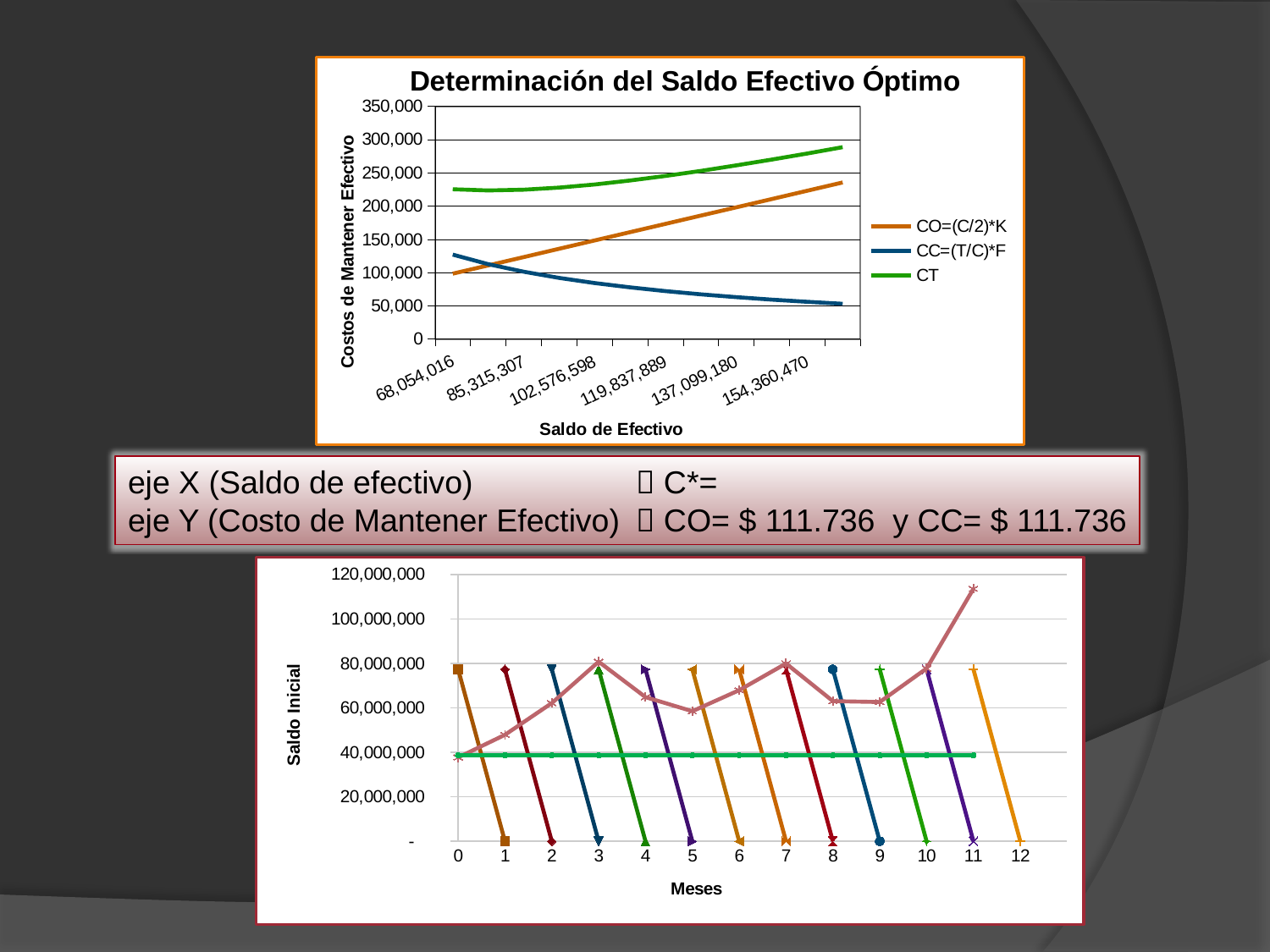
In the bottom chart with 'Meses' on the x axis, is the value of the pink line at month 11 greater or less than 100,000,000? greater What kind of chart is the top chart titled 'Determinación del Saldo Efectivo Óptimo'? line chart In the top chart 'Determinación del Saldo Efectivo Óptimo', is the CC=(T/C)*F value at 154,360,470 greater or less than 100,000? less In the top chart 'Determinación del Saldo Efectivo Óptimo', which series has the highest value at the rightmost point of the x axis? CT What is the y-axis title of the bottom chart with 'Meses' on the x axis? Saldo Inicial In the top chart 'Determinación del Saldo Efectivo Óptimo', does the CC=(T/C)*F series rise or fall as Saldo de Efectivo increases? falls In the top chart 'Determinación del Saldo Efectivo Óptimo', is the CO=(C/2)*K value at 68,054,016 greater or less than 150,000? less What kind of chart is the bottom chart with 'Meses' on the x axis? line chart How many series does the legend of the top chart 'Determinación del Saldo Efectivo Óptimo' list? 3 What are the legend entries of the top chart 'Determinación del Saldo Efectivo Óptimo'? CO=(C/2)*K, CC=(T/C)*F, CT In the top chart 'Determinación del Saldo Efectivo Óptimo', does the CO=(C/2)*K series rise or fall as Saldo de Efectivo increases? rises